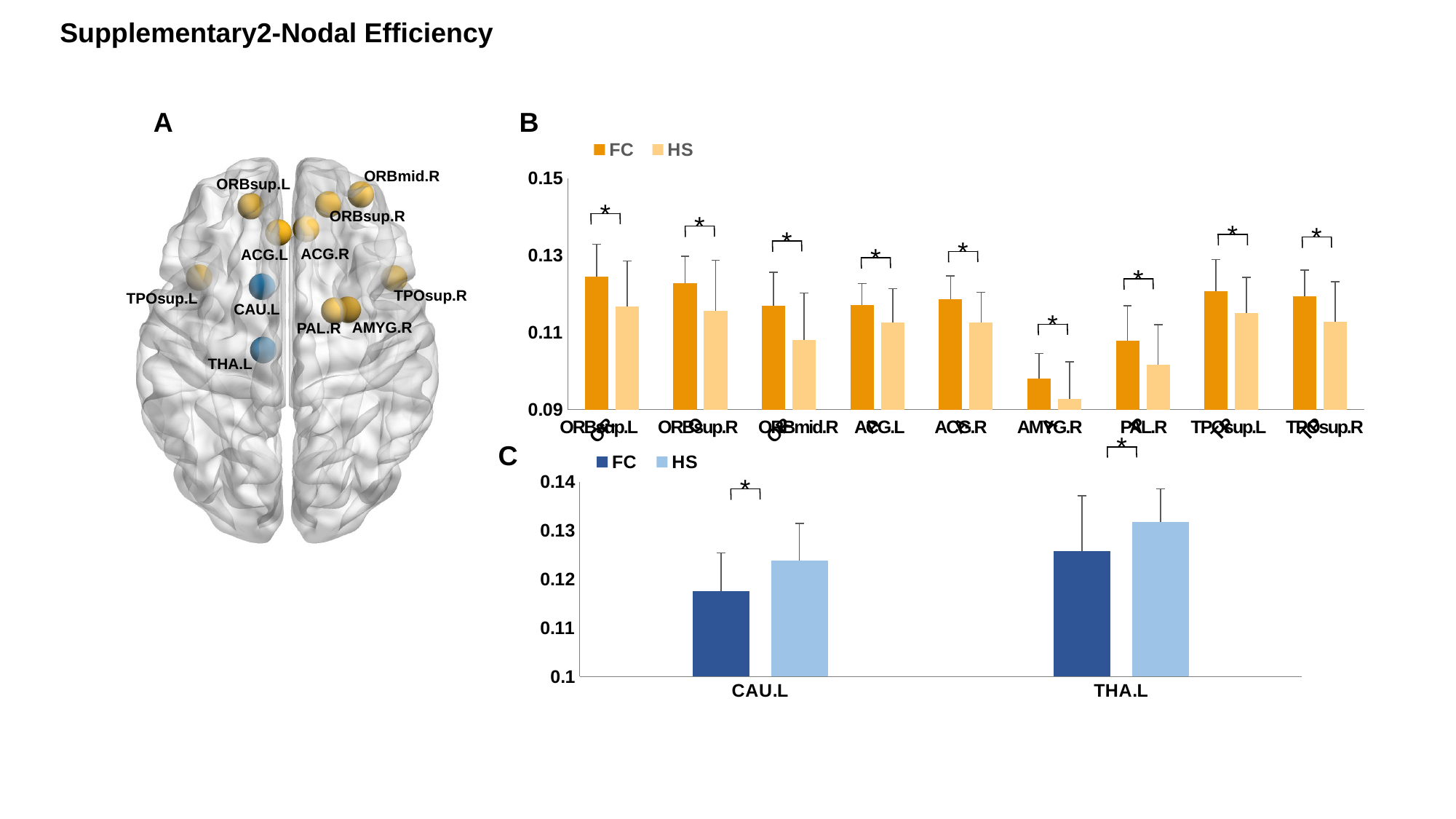
How many categories are shown on the x axis of chart B? 9 In chart B, which category has the lowest FC value? AMYG.R How many series does the legend of chart C list? 2 In chart B, which category has the lowest HS value? AMYG.R What kind of chart is chart B? bar chart In chart C, which is larger for THA.L, the FC value or the HS value? HS In chart B, is the FC value for AMYG.R greater or less than 0.11? less In chart B, is the FC value for ORBsup.L greater or less than 0.12? greater What are the two series named in the legend of chart B? FC and HS In chart C, is the FC value for THA.L greater or less than 0.12? greater In chart B, which is larger for AMYG.R, the FC value or the HS value? FC In chart C, which category has the higher HS value, CAU.L or THA.L? THA.L